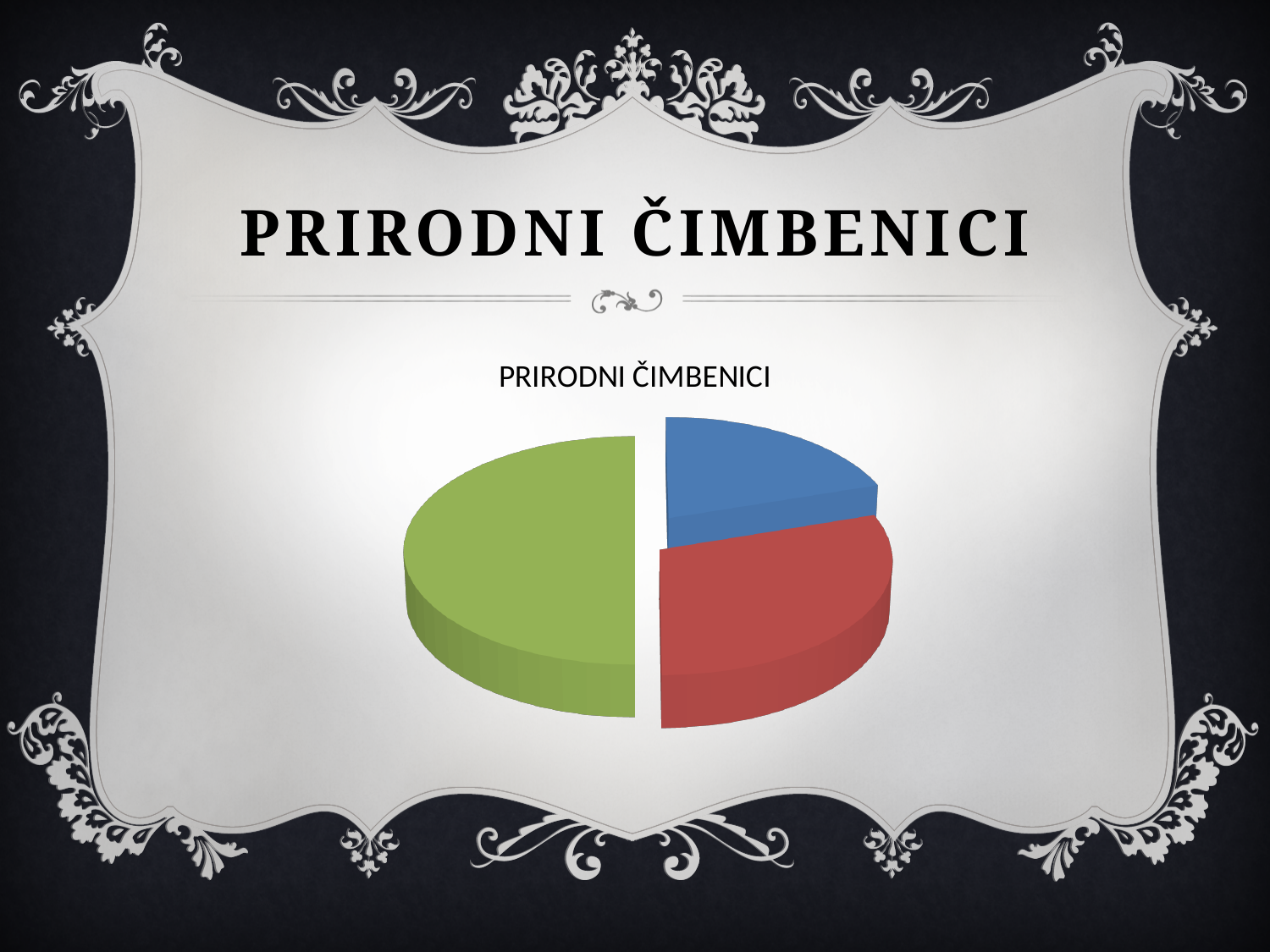
What is the title of the chart? PRIRODNI ČIMBENICI Which colour slice is the smallest in the pie chart? blue How many slices does the pie chart have? 3 Which slice is larger, the green one or the red one? green Does the chart display a legend? no What kind of chart is shown on the slide? pie chart Which colour slice is the largest in the pie chart? green Which slice is larger, the red one or the blue one? red